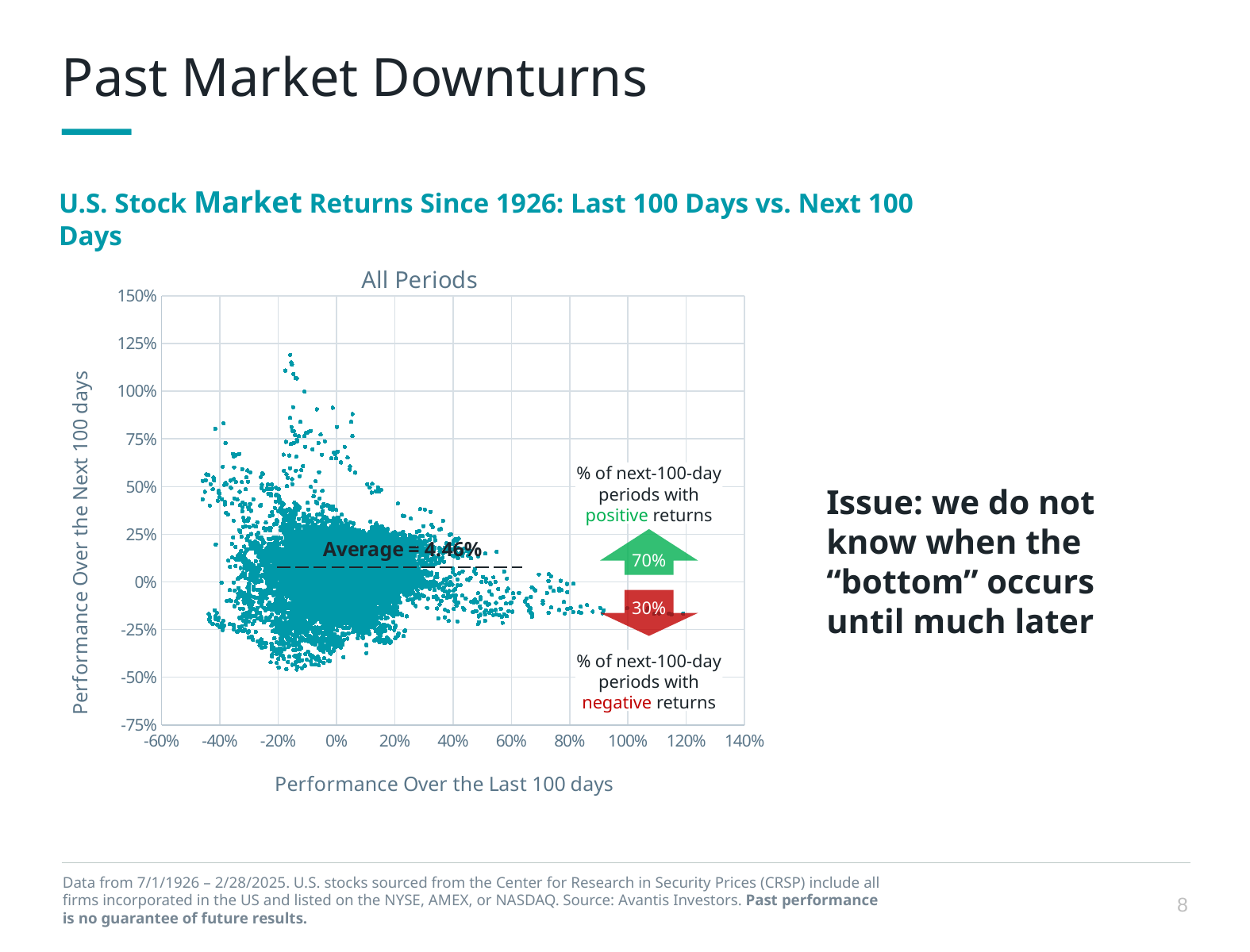
What do the shares of positive and negative next-100-day periods add up to? 100% What is the average performance over the next 100 days shown on the chart? 4.46% What is the title of the chart? All Periods What kind of chart is shown on the slide? scatter chart Which is larger: the share of next-100-day periods with positive returns or with negative returns? positive returns What percentage of next-100-day periods had positive returns? 70% Is the average performance over the next 100 days greater or less than 25%? less What is the difference between the share of next-100-day periods with positive returns and the share with negative returns? 40% What percentage of next-100-day periods had negative returns? 30% What is the label of the x axis of the chart? Performance Over the Last 100 days